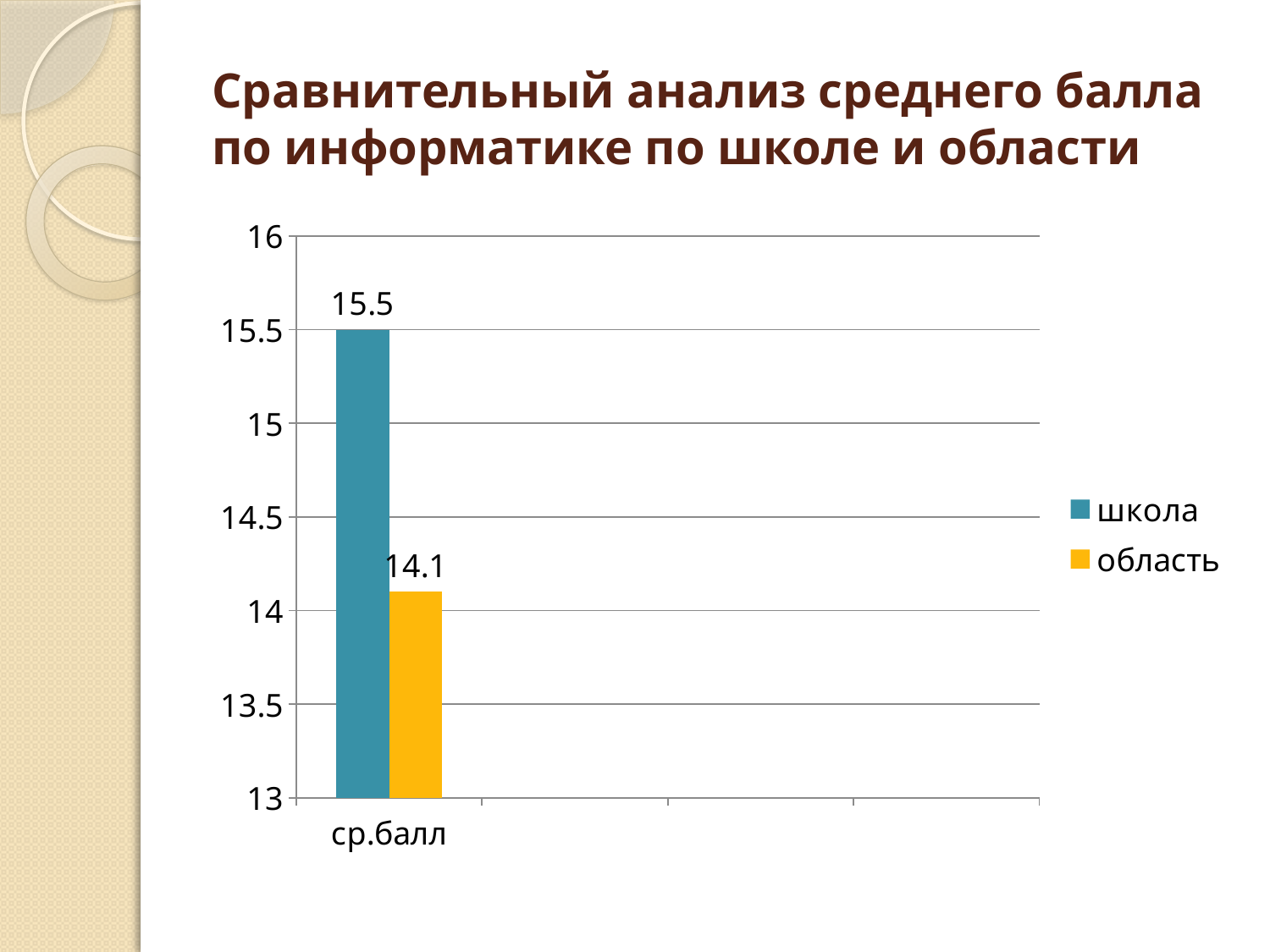
How many categories are shown on the x axis? 1 What colour is the bar for школа? teal (blue-green) Which series has the higher value: школа or область? школа Is the value for область greater or less than 14.5? less What is the difference between the школа value and the область value? 1.4 What is the value for область in the ср.балл category? 14.1 What kind of chart is shown on the slide? bar chart Which series has the lowest value on the chart? область What is the label of the category on the x axis? ср.балл How many series does the legend list? 2 What is the value for школа in the ср.балл category? 15.5 Is the value for школа greater or less than 15? greater